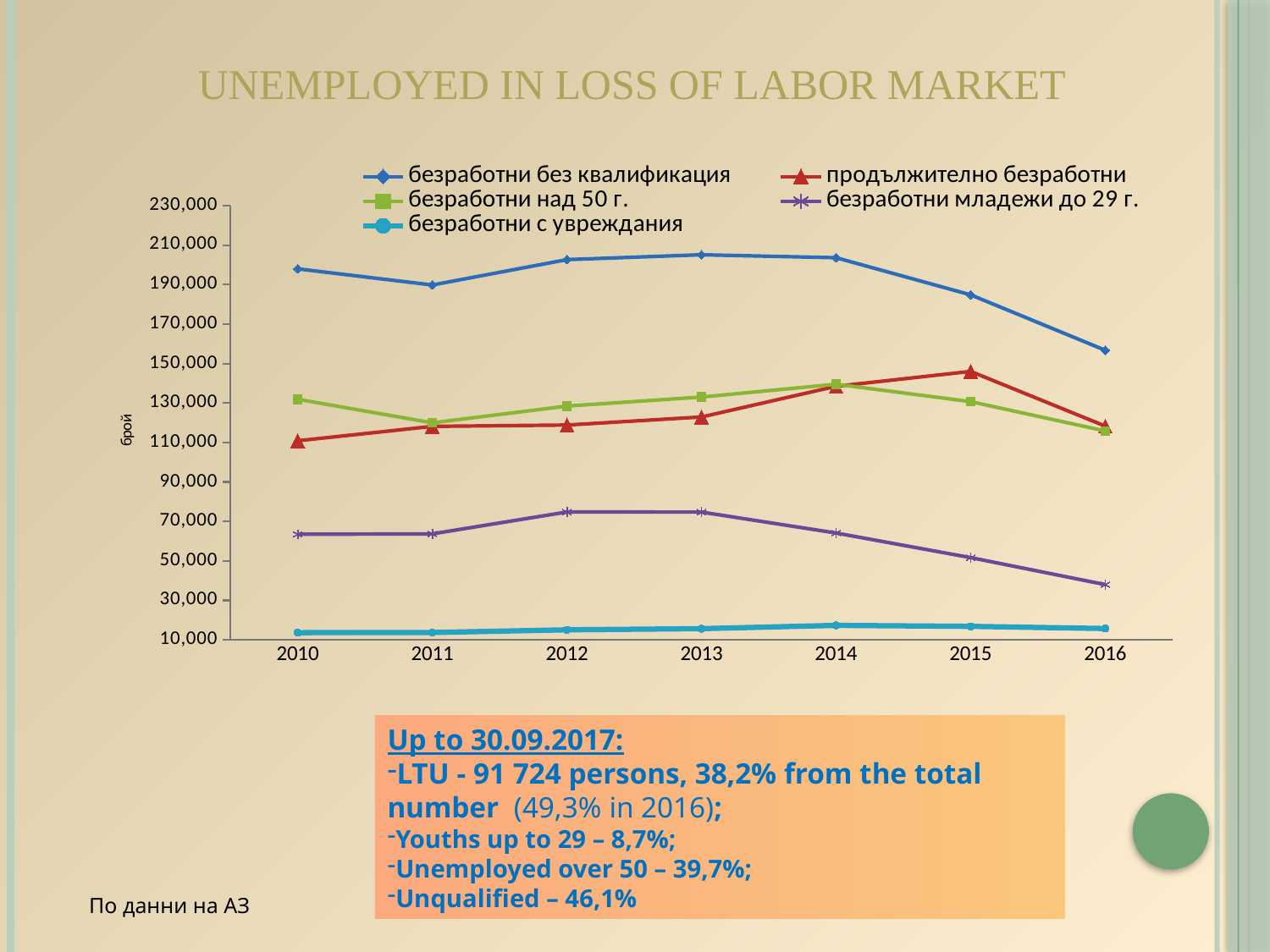
How many years are plotted along the x axis? 7 Which series has the highest values across all years? безработни без квалификация How many series does the legend list? 5 Is the value for безработни без квалификация in 2013 greater or less than 190,000? greater In which year does the series продължително безработни reach its highest value? 2015 What kind of chart is shown on the slide? line chart Is the value for безработни младежи до 29 г. in 2016 greater or less than 50,000? less In 2010, which is larger: безработни над 50 г. or продължително безработни? безработни над 50 г. In 2015, which is larger: продължително безработни or безработни над 50 г.? продължително безработни In which year does the series безработни без квалификация reach its lowest value? 2016 Does the series безработни младежи до 29 г. rise or fall from 2013 to 2016? fall Which series has the lowest values across all years? безработни с увреждания